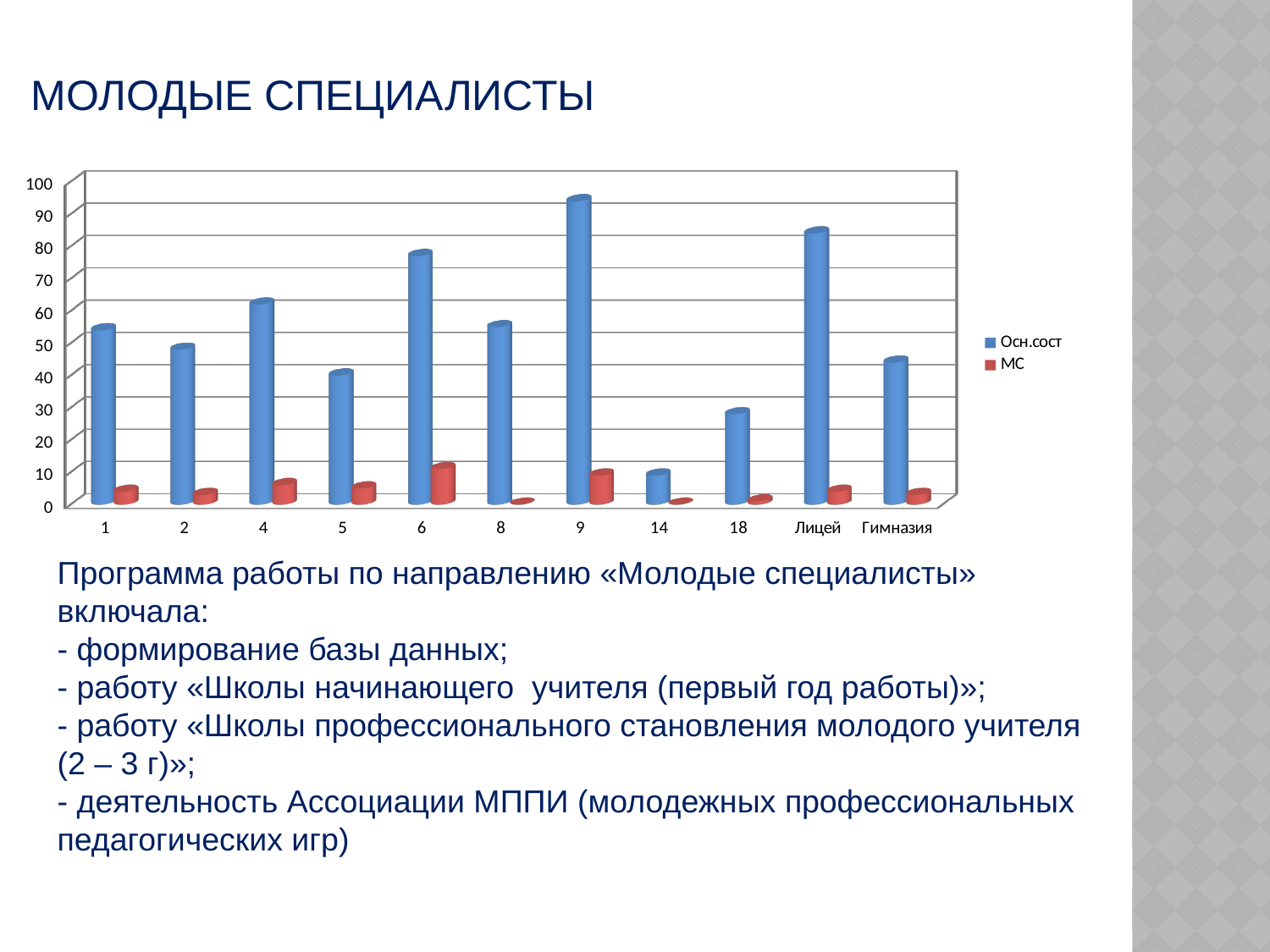
Is the value for Осн.сост in category 9 greater or less than 90? greater What are the two series named in the legend? Осн.сост and МС Which is larger for Осн.сост: category 6 or category 5? 6 How many series does the legend list? 2 Which is larger for Осн.сост: Лицей or Гимназия? Лицей Which category has the highest value for МС? 6 How many categories are shown on the x axis? 11 Which category has the lowest value for Осн.сост? 14 Which category has the highest value for Осн.сост? 9 What kind of chart is shown on the slide? bar chart